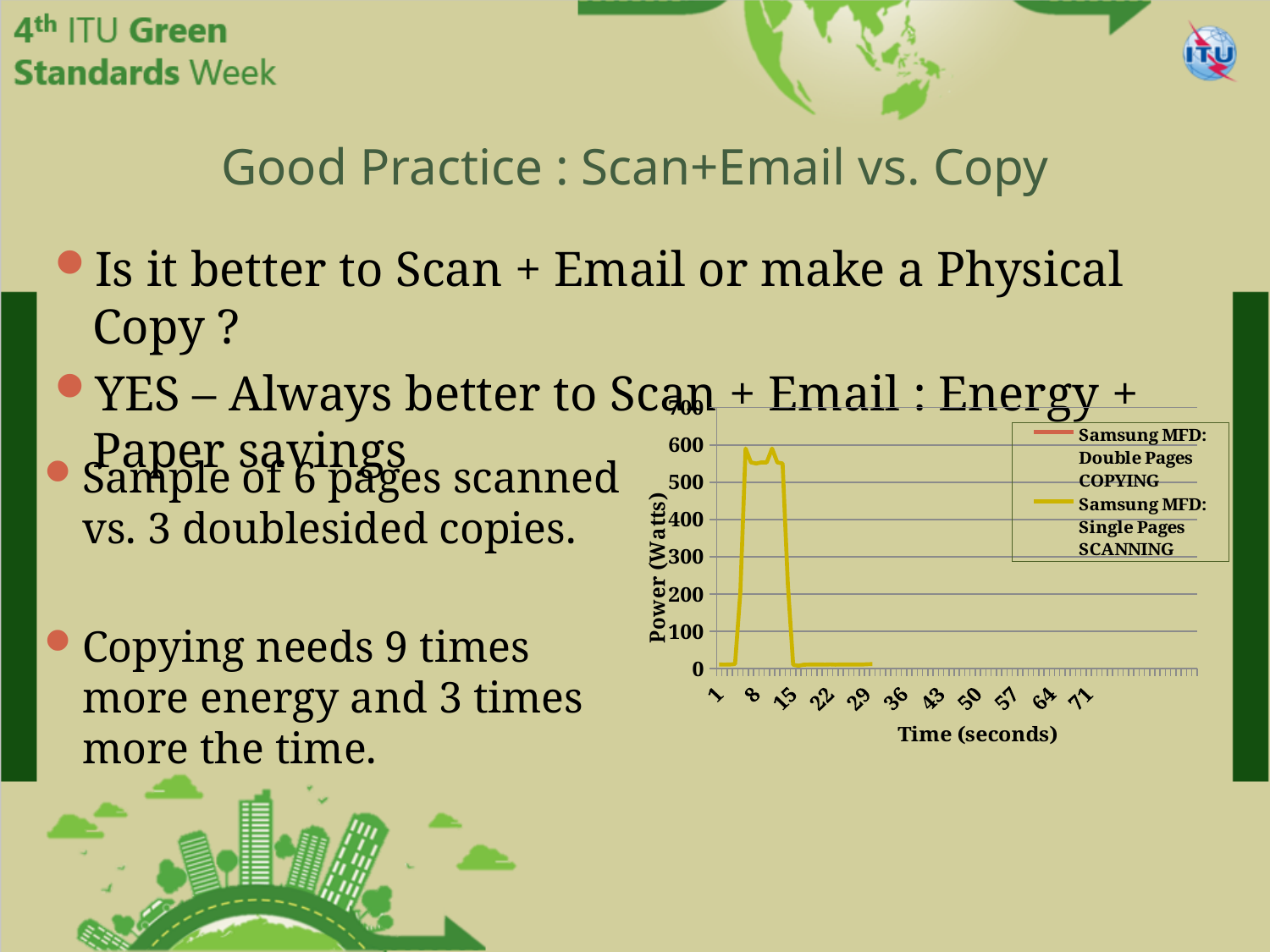
How many series does the chart's legend list? 2 What kind of chart is shown on the slide? line chart What is the title of the chart's horizontal axis? Time (seconds) Is the value of the Samsung MFD: Single Pages SCANNING line at time 29 greater or less than 100? less Is the peak value of the Samsung MFD: Single Pages SCANNING line greater or less than 500? greater Which series in the legend is drawn in yellow? Samsung MFD: Single Pages SCANNING Is the peak value of the Samsung MFD: Single Pages SCANNING line greater or less than 700? less What is the title of the chart's vertical axis? Power (Watts)